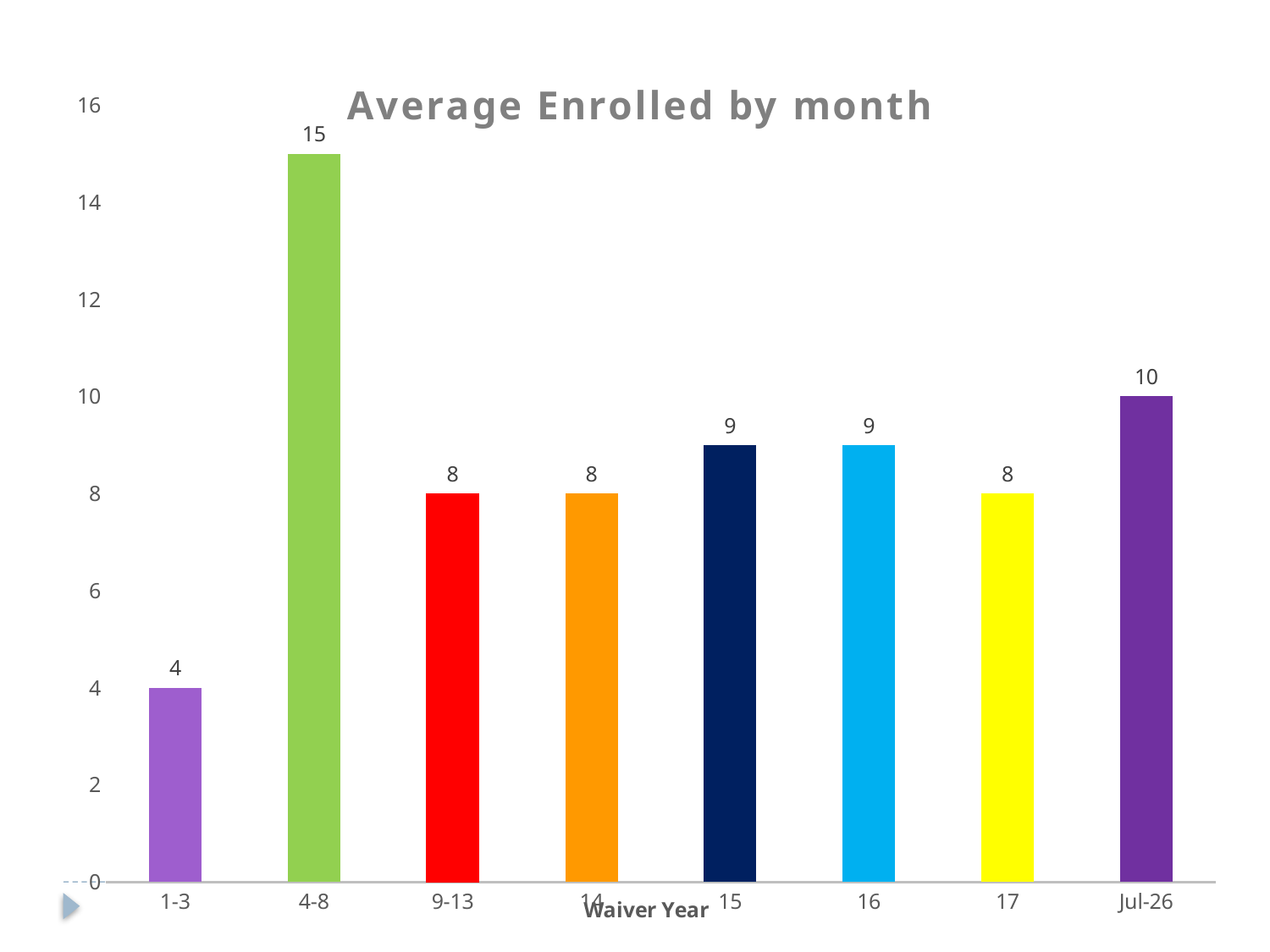
What is the value shown for Jul-26? 10 What kind of chart is shown on the slide? Bar chart What is the difference between the values for Jul-26 and waiver year 17? 2 Which waiver year has the highest average enrolled by month? 4-8 What is the value shown for waiver year 17? 8 Which waiver year has the lowest average enrolled by month? 1-3 What is the title of the chart? Average Enrolled by month What is the average enrolled by month for waiver year 4-8? 15 How many bars are shown in the chart? 8 Which is larger, the value for waiver year 15 or the value for waiver year 9-13? Waiver year 15 What is the difference between the values for waiver year 4-8 and waiver year 1-3? 11 What is the average enrolled by month for waiver year 1-3? 4